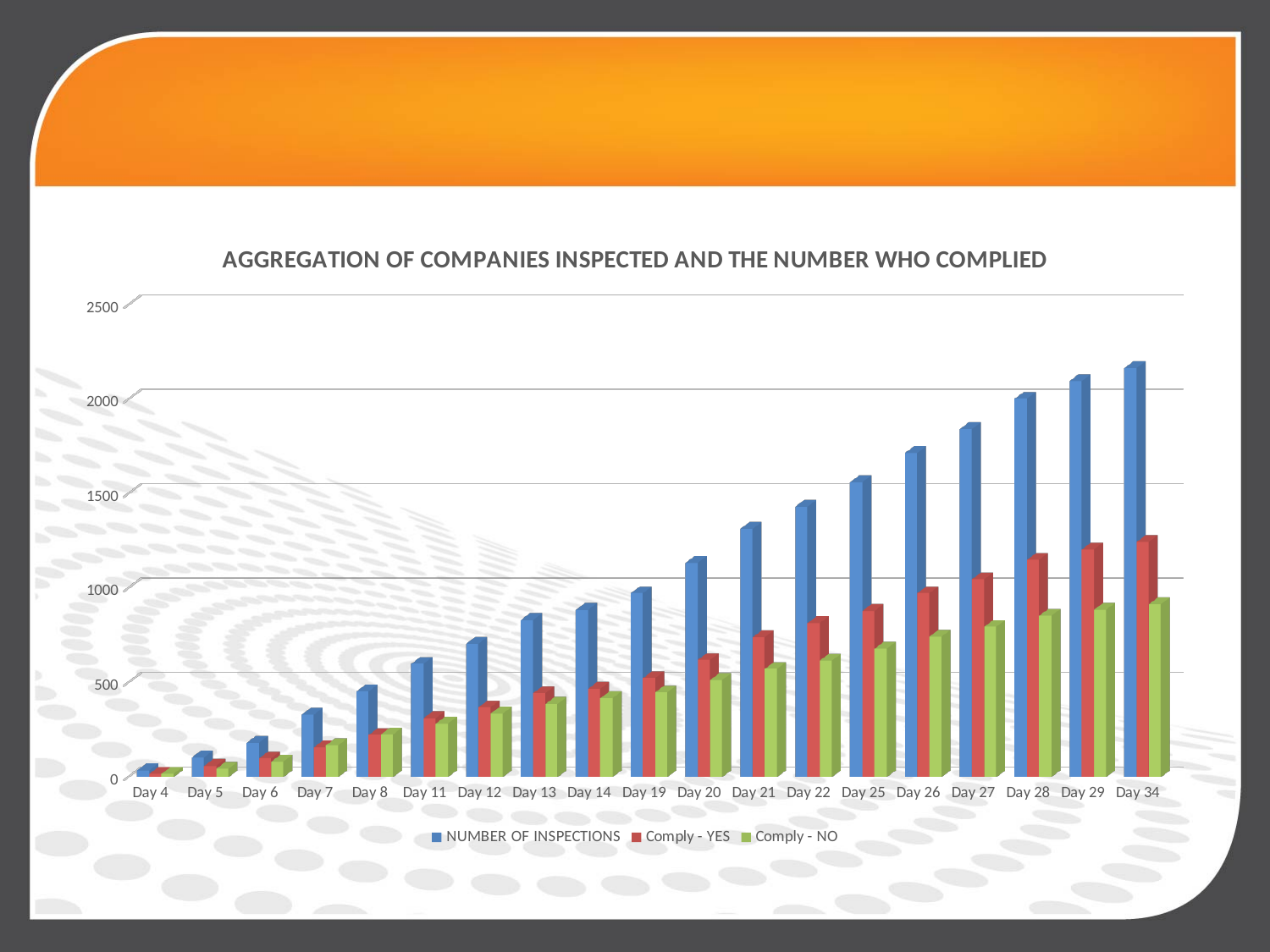
How many series does the legend list? 3 Which day has the lowest NUMBER OF INSPECTIONS? Day 4 Is the Comply - NO value for Day 34 greater or less than 1000? less Is the NUMBER OF INSPECTIONS for Day 34 greater or less than 2000? greater Does the NUMBER OF INSPECTIONS rise or fall from Day 4 to Day 34? rise What is the title of the chart? AGGREGATION OF COMPANIES INSPECTED AND THE NUMBER WHO COMPLIED How many day categories are shown on the x axis? 19 What kind of chart is shown on the slide? bar chart For Day 34, which is larger: Comply - YES or Comply - NO? Comply - YES Which day has the highest NUMBER OF INSPECTIONS? Day 34 Is the NUMBER OF INSPECTIONS for Day 21 greater or less than 1000? greater